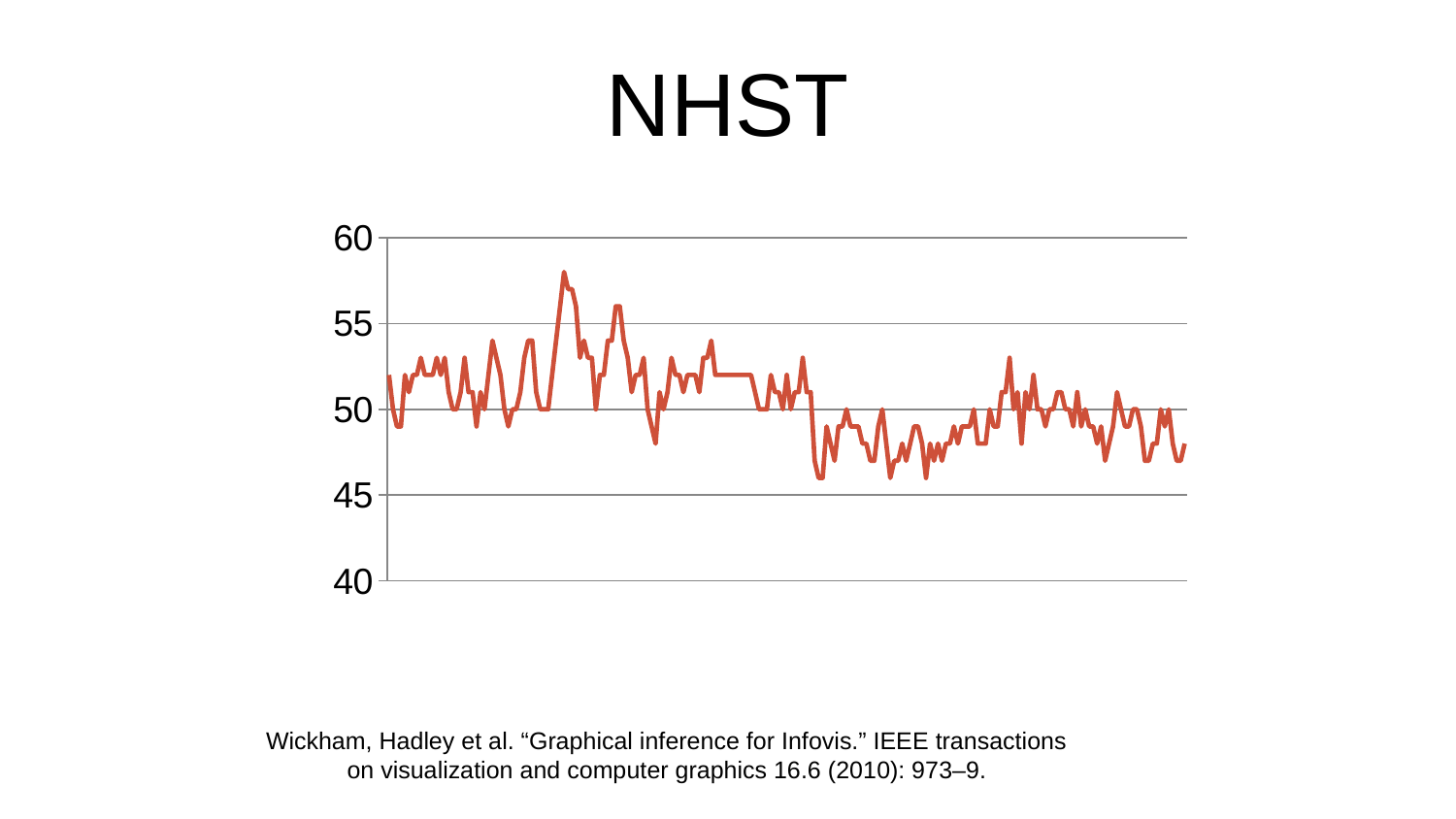
What is the lowest value shown on the chart's vertical axis? 40 What kind of chart is shown on the slide? line chart Is the value at the far left end of the line greater or less than 50? greater Is the lowest point of the line greater or less than 45? greater What is the highest value shown on the chart's vertical axis? 60 Is the lowest point of the line greater or less than 50? less Overall, do the values of the line tend to rise or fall from left to right? fall How many lines (series) are plotted on the chart? 1